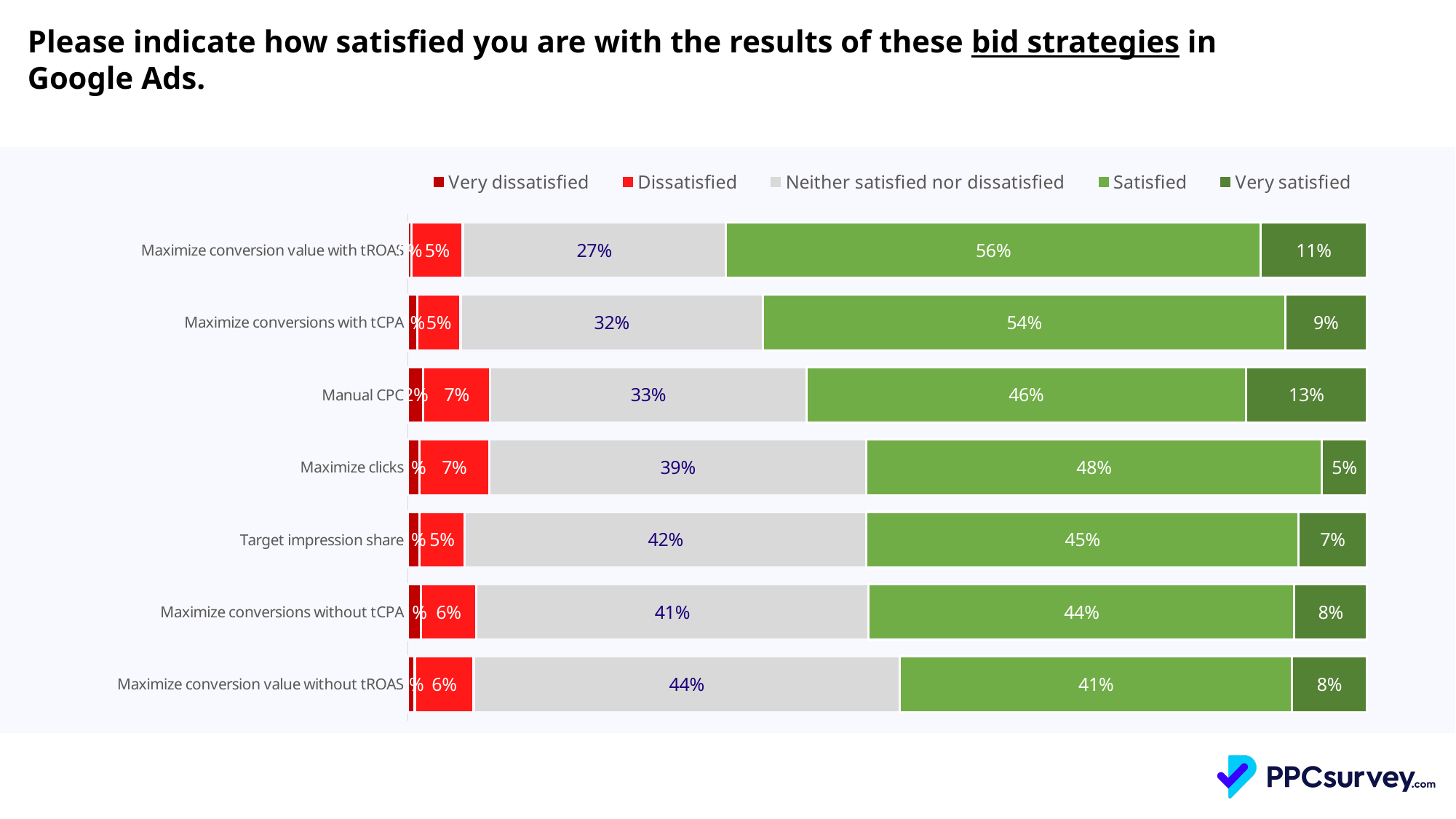
Which legend entry is shown in light grey? Neither satisfied nor dissatisfied What is the Very satisfied value for Manual CPC? 13% What is the Dissatisfied value for Maximize clicks? 7% Which bid strategy has the highest Very satisfied value? Manual CPC What kind of chart is shown on the slide? Stacked bar chart What is the Neither satisfied nor dissatisfied value for Maximize conversion value without tROAS? 44% What is the difference between the Satisfied values for Maximize conversions with tCPA and Maximize conversions without tCPA? 10% What is the Satisfied value for Maximize conversion value with tROAS? 56% Which is larger: the Neither satisfied nor dissatisfied value for Target impression share or for Maximize clicks? Target impression share How many bid strategies are shown in the chart? 7 Which bid strategy has the lowest Satisfied value? Maximize conversion value without tROAS How many series does the legend list? 5